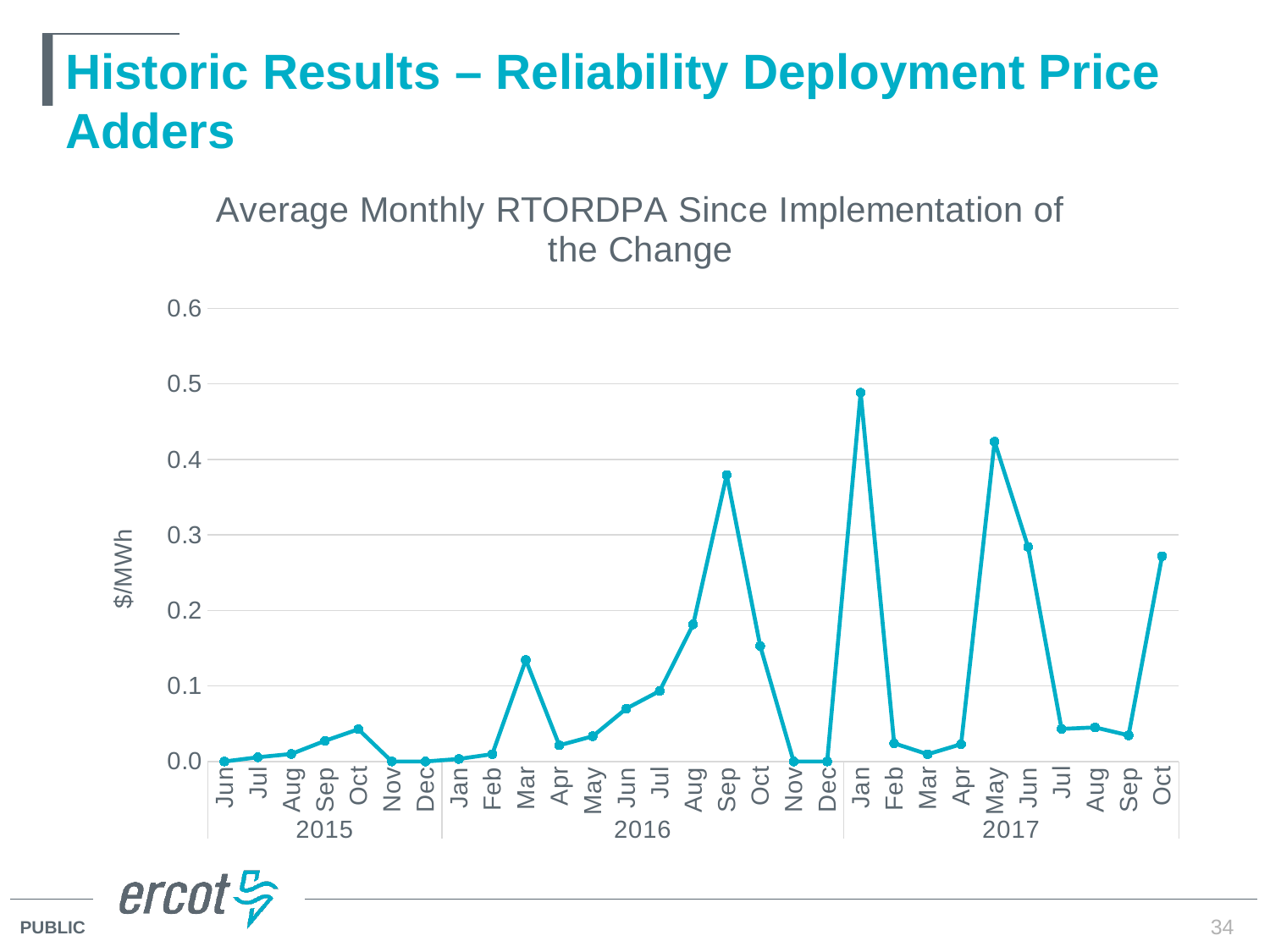
Is the value for Jan 2017 greater or less than 0.4? greater How many monthly data points are plotted on the chart? 29 Which is larger, the value for Jan 2017 or the value for Sep 2016? Jan 2017 What kind of chart is shown on the slide? line chart Is the value for Oct 2017 greater or less than 0.3? less Do the values rise or fall from Apr 2016 to Sep 2016? rise What is the title of the chart? Average Monthly RTORDPA Since Implementation of the Change Which month has the highest average RTORDPA on the chart? Jan 2017 Is the value for Sep 2016 greater or less than 0.3? greater What unit is shown on the y-axis label of the chart? $/MWh